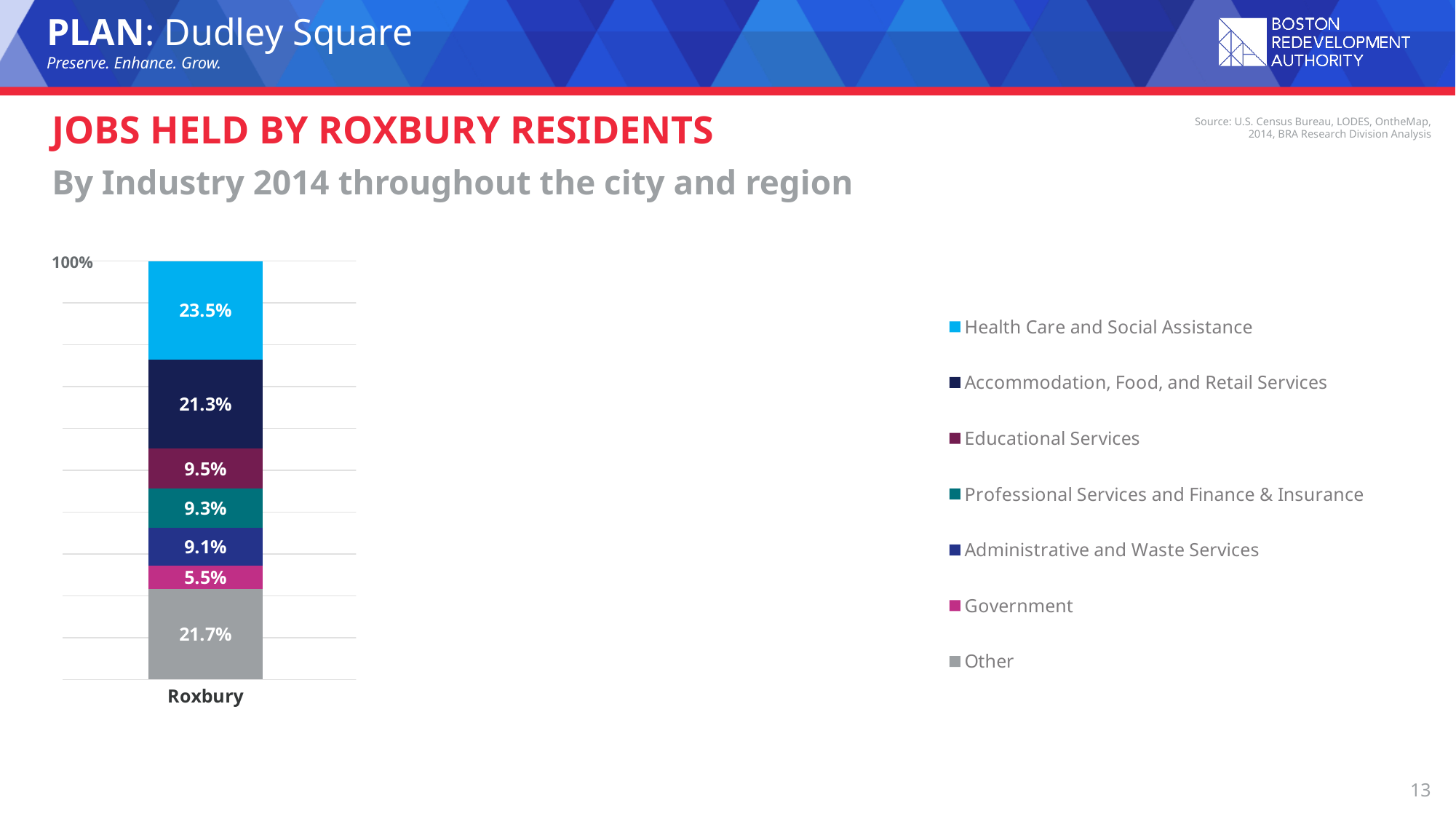
How many categories are shown on the x axis of the chart? 1 What is the value shown for Government in the Roxbury bar? 5.5% What share of the Roxbury bar is Accommodation, Food, and Retail Services? 21.3% How many percentage points larger is the Health Care and Social Assistance share than the Accommodation, Food, and Retail Services share? 2.2 percentage points Which industry has the largest share of jobs held by Roxbury residents? Health Care and Social Assistance How many series does the legend list? 7 Which industry has the smallest share in the Roxbury bar? Government What kind of chart is shown on the slide? Stacked bar chart Which is larger: the share for Other or the share for Accommodation, Food, and Retail Services? Other What percentage of jobs held by Roxbury residents are in Health Care and Social Assistance? 23.5% What percentage is labelled for Professional Services and Finance & Insurance? 9.3% Which is larger: Educational Services or Administrative and Waste Services? Educational Services